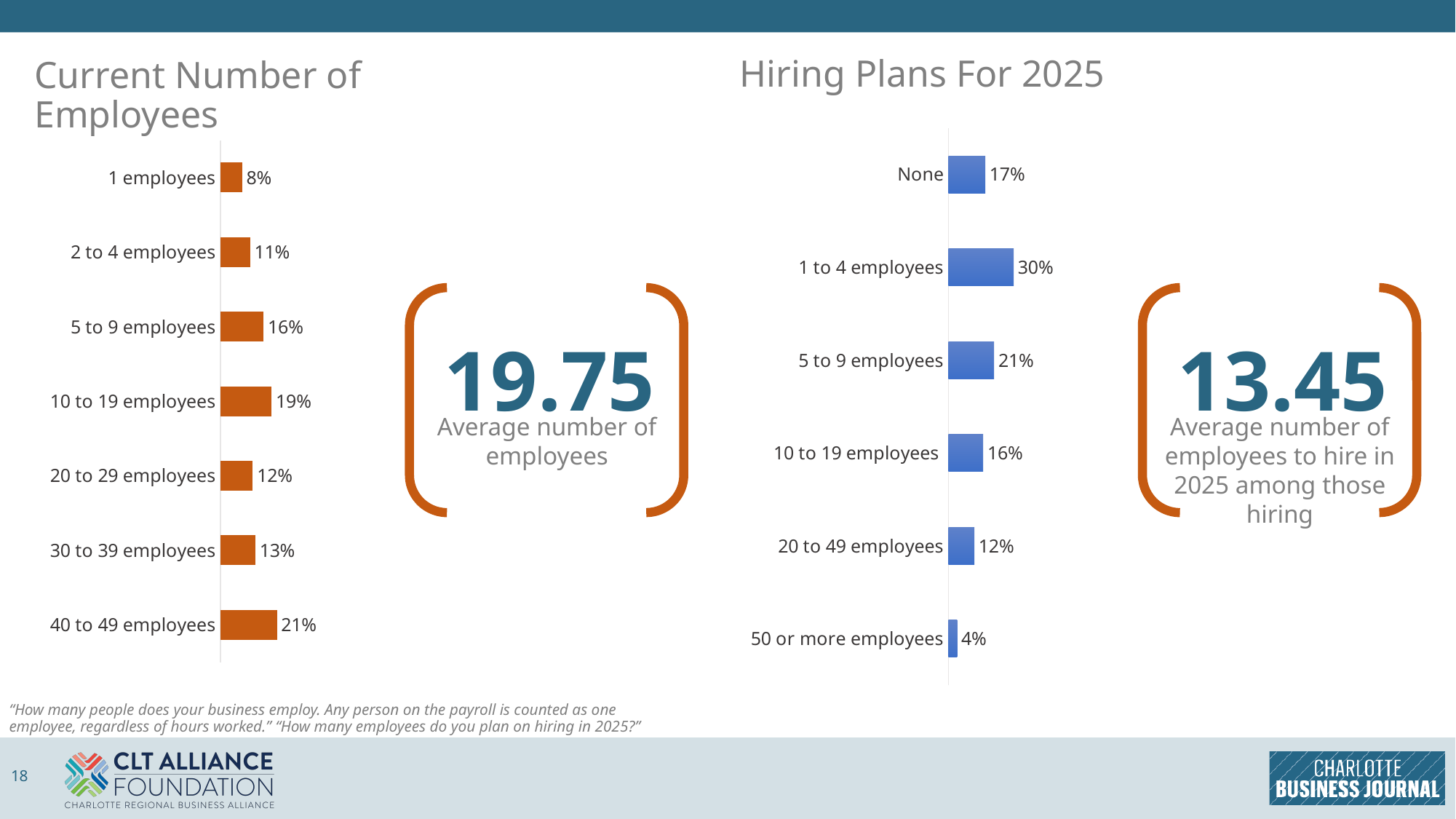
In the 'Hiring Plans For 2025' chart, what percentage plan to hire 1 to 4 employees? 30% In the 'Current Number of Employees' chart, which category has the lowest percentage? 1 employees In the 'Hiring Plans For 2025' chart, which is larger: the percentage for None or the percentage for 5 to 9 employees? 5 to 9 employees What is the average number of employees shown next to the 'Current Number of Employees' chart? 19.75 In the 'Hiring Plans For 2025' chart, which category has the lowest percentage? 50 or more employees In the 'Current Number of Employees' chart, how many categories are shown? 7 In the 'Current Number of Employees' chart, what is the difference between the percentages for 10 to 19 employees and 20 to 29 employees? 7% In the 'Current Number of Employees' chart, which category has the highest percentage? 40 to 49 employees In the 'Hiring Plans For 2025' chart, what is the difference between the percentages for 1 to 4 employees and 50 or more employees? 26% What type of chart is the 'Hiring Plans For 2025' chart? Bar chart In the 'Current Number of Employees' chart, what percentage of businesses have 5 to 9 employees? 16% What is the average number of employees to hire in 2025 among those hiring, as shown next to the 'Hiring Plans For 2025' chart? 13.45